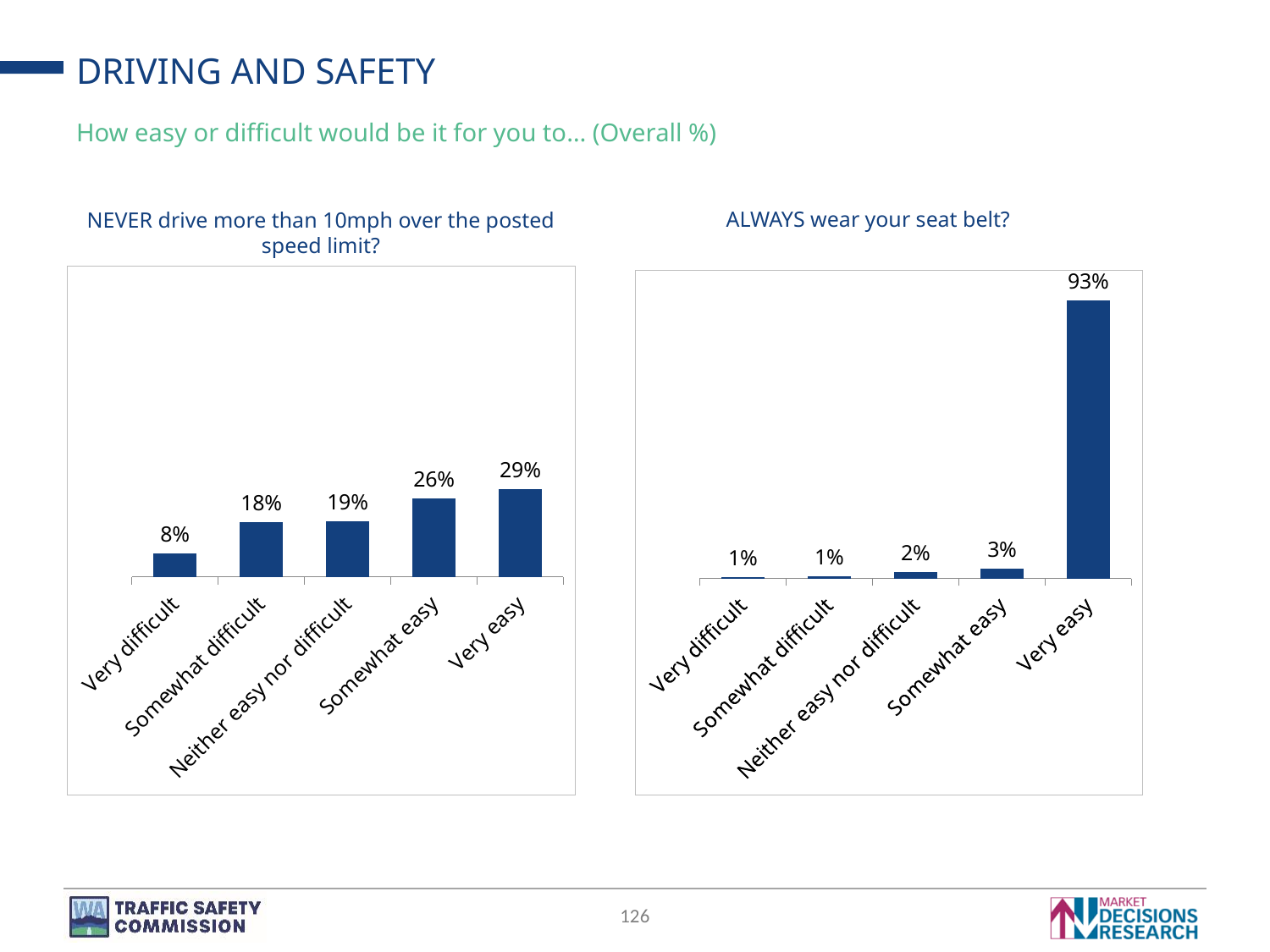
In the 'ALWAYS wear your seat belt?' chart, which is larger: Neither easy nor difficult or Somewhat easy? Somewhat easy In the 'NEVER drive more than 10mph over the posted speed limit?' chart, which category has the lowest value? Very difficult In the 'ALWAYS wear your seat belt?' chart, which category has the highest value? Very easy In the 'ALWAYS wear your seat belt?' chart, what is the difference between Very easy and Somewhat easy? 90% In the 'NEVER drive more than 10mph over the posted speed limit?' chart, what is the difference between Very easy and Very difficult? 21% What kind of chart is the 'ALWAYS wear your seat belt?' chart? Bar chart In the 'NEVER drive more than 10mph over the posted speed limit?' chart, which is larger: Somewhat difficult or Somewhat easy? Somewhat easy In the 'NEVER drive more than 10mph over the posted speed limit?' chart, what is the value for Neither easy nor difficult? 19% In the 'NEVER drive more than 10mph over the posted speed limit?' chart, what is the value for Somewhat easy? 26% How many categories are shown in the 'NEVER drive more than 10mph over the posted speed limit?' chart? 5 In the 'ALWAYS wear your seat belt?' chart, what is the value for Very easy? 93% In the 'NEVER drive more than 10mph over the posted speed limit?' chart, do the values rise or fall from Very difficult to Very easy? Rise